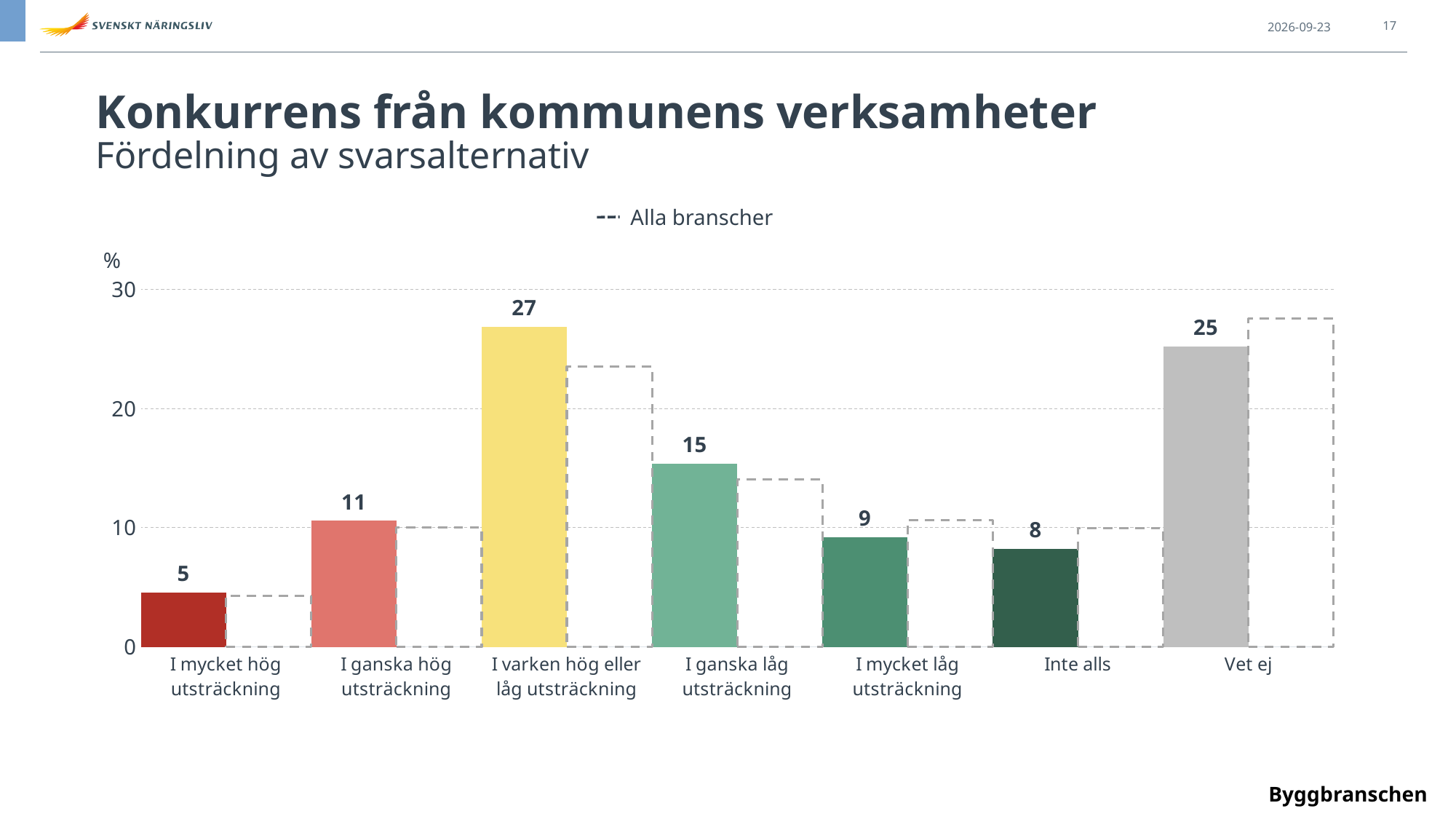
Which category has the lowest value? I mycket hög utsträckning What is the value for "Vet ej"? 25 What is the difference between the values for "I varken hög eller låg utsträckning" and "Vet ej"? 2 What is the legend entry shown above the chart? Alla branscher Which category has the highest value? I varken hög eller låg utsträckning Is the dashed "Alla branscher" value for "Vet ej" greater or less than 25? greater Which is larger, the value for "I ganska hög utsträckning" or the value for "I ganska låg utsträckning"? I ganska låg utsträckning How many entries does the legend list? 1 How many categories are shown on the x axis? 7 What is the value for "I mycket hög utsträckning"? 5 What kind of chart is shown on the slide? Bar chart What is the value for "I varken hög eller låg utsträckning"? 27